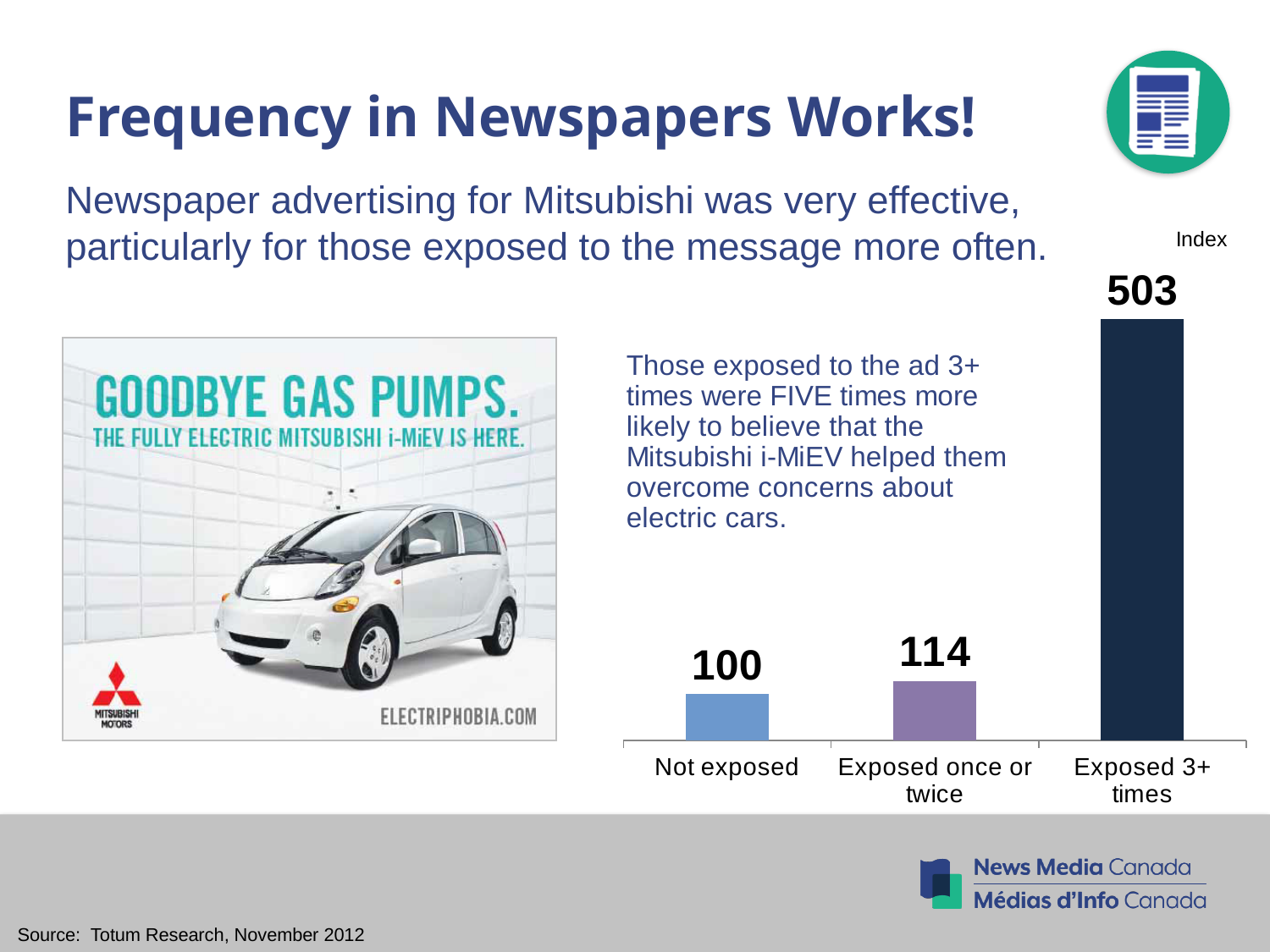
What kind of chart is shown on the slide? Bar chart What is the index value for the 'Not exposed' group? 100 Which exposure group has the lowest index value? Not exposed What is the difference between the index values for 'Exposed 3+ times' and 'Not exposed'? 403 Do the index values rise or fall moving from 'Not exposed' to 'Exposed 3+ times'? Rise What is the index value for the 'Exposed 3+ times' group? 503 Which has a larger index value, 'Exposed once or twice' or 'Exposed 3+ times'? Exposed 3+ times What label appears above the chart indicating the unit of the values? Index Which exposure group has the highest index value? Exposed 3+ times What is the index value for the 'Exposed once or twice' group? 114 How many exposure categories are shown in the chart? 3 What is the difference between the index values for 'Exposed once or twice' and 'Not exposed'? 14